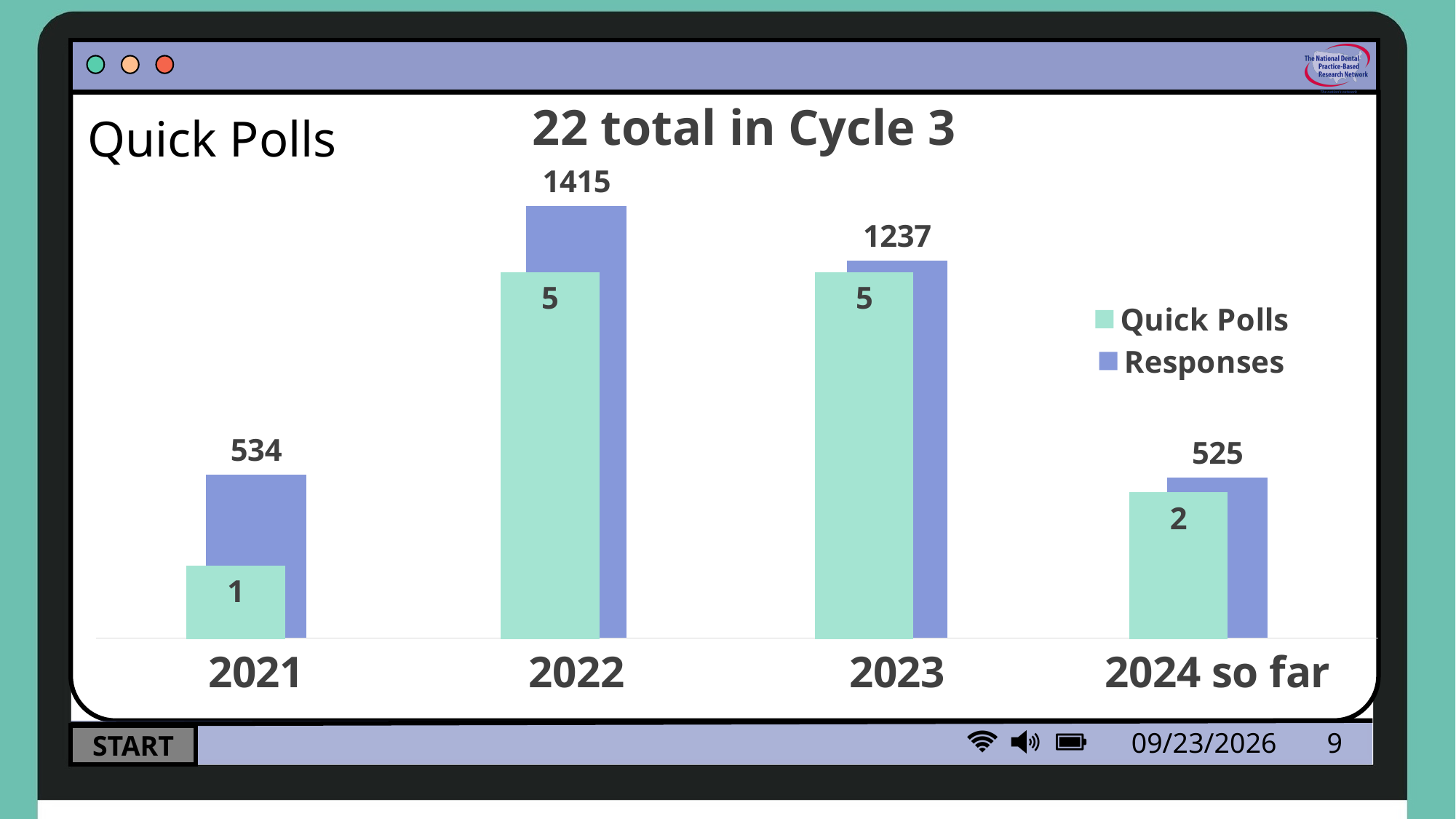
What is the difference in Responses between 2022 and 2023? 178 How many categories are shown on the x axis? 4 How many Quick Polls were there in 2024 so far? 2 Which year has the highest number of Responses? 2022 What is the number of Responses for 2022? 1415 Which has more Responses, 2021 or 2024 so far? 2021 How many Quick Polls were there in 2023? 5 What is the number of Responses for 2021? 534 What is the title shown above the chart? 22 total in Cycle 3 What kind of chart is shown on the slide? Bar chart Which year has the lowest number of Quick Polls? 2021 How many series does the legend list? 2